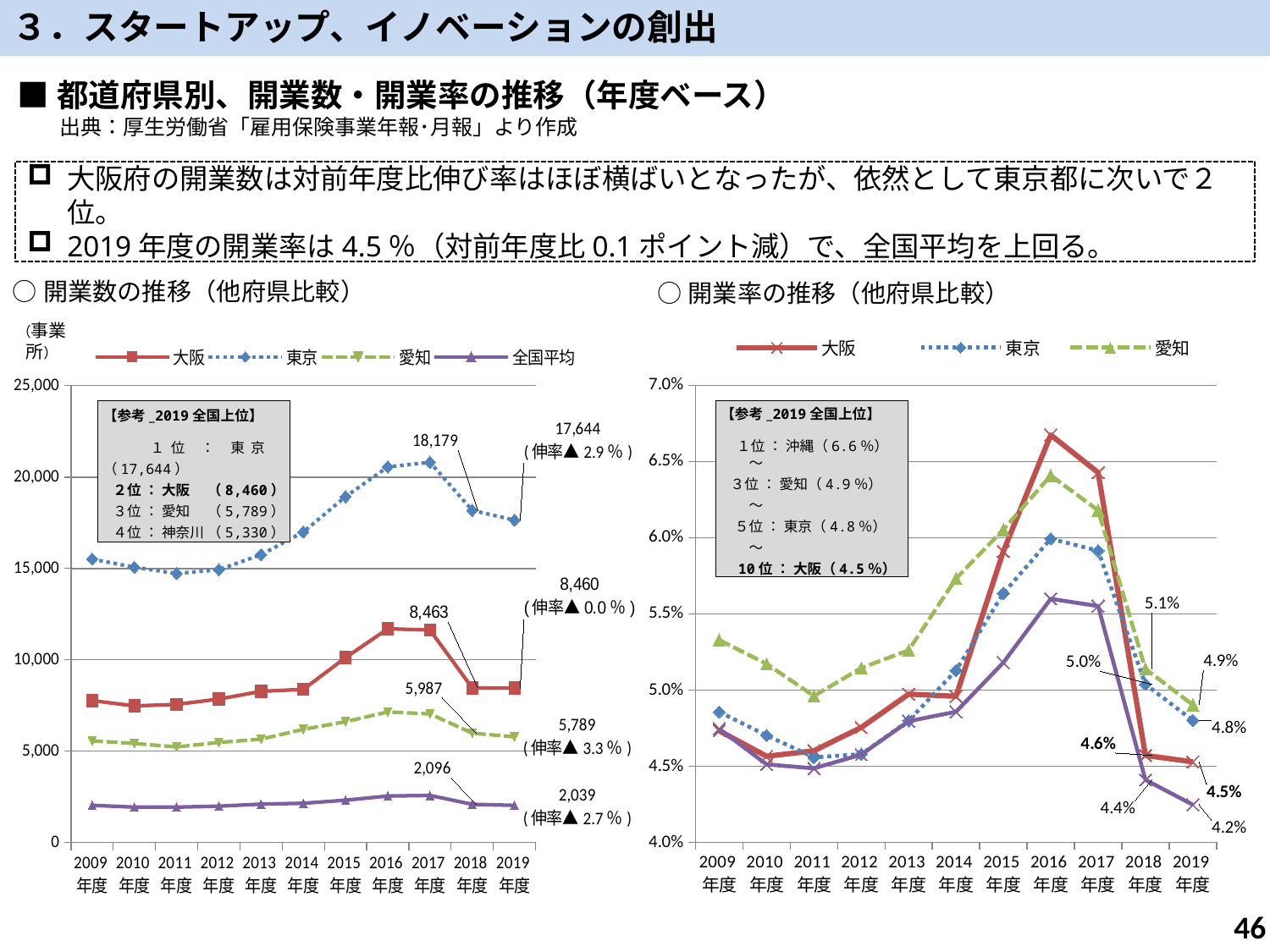
In the right chart (開業率の推移), which is larger in 2019年度, the value for 愛知 or the value for 大阪? 愛知 In the left chart (開業数の推移), which series has the highest value in 2019年度? 東京 In the left chart (開業数の推移), how many fiscal years are plotted on the x axis? 11 In the left chart (開業数の推移), what is the value for 東京 in 2019年度? 17,644 In the right chart (開業率の推移), what is the value for 愛知 in 2018年度? 5.1% In the right chart (開業率の推移), is the value for 大阪 in 2016年度 greater or less than 6.5%? greater What kind of chart is the left chart titled 開業数の推移（他府県比較）? line chart In the right chart (開業率の推移), what is the value for 大阪 in 2019年度? 4.5% In the right chart (開業率の推移), how many series does the legend list? 3 In the left chart (開業数の推移), how many series does the legend list? 4 In the left chart (開業数の推移), what is the difference between the 東京 and 大阪 values in 2019年度? 9,184